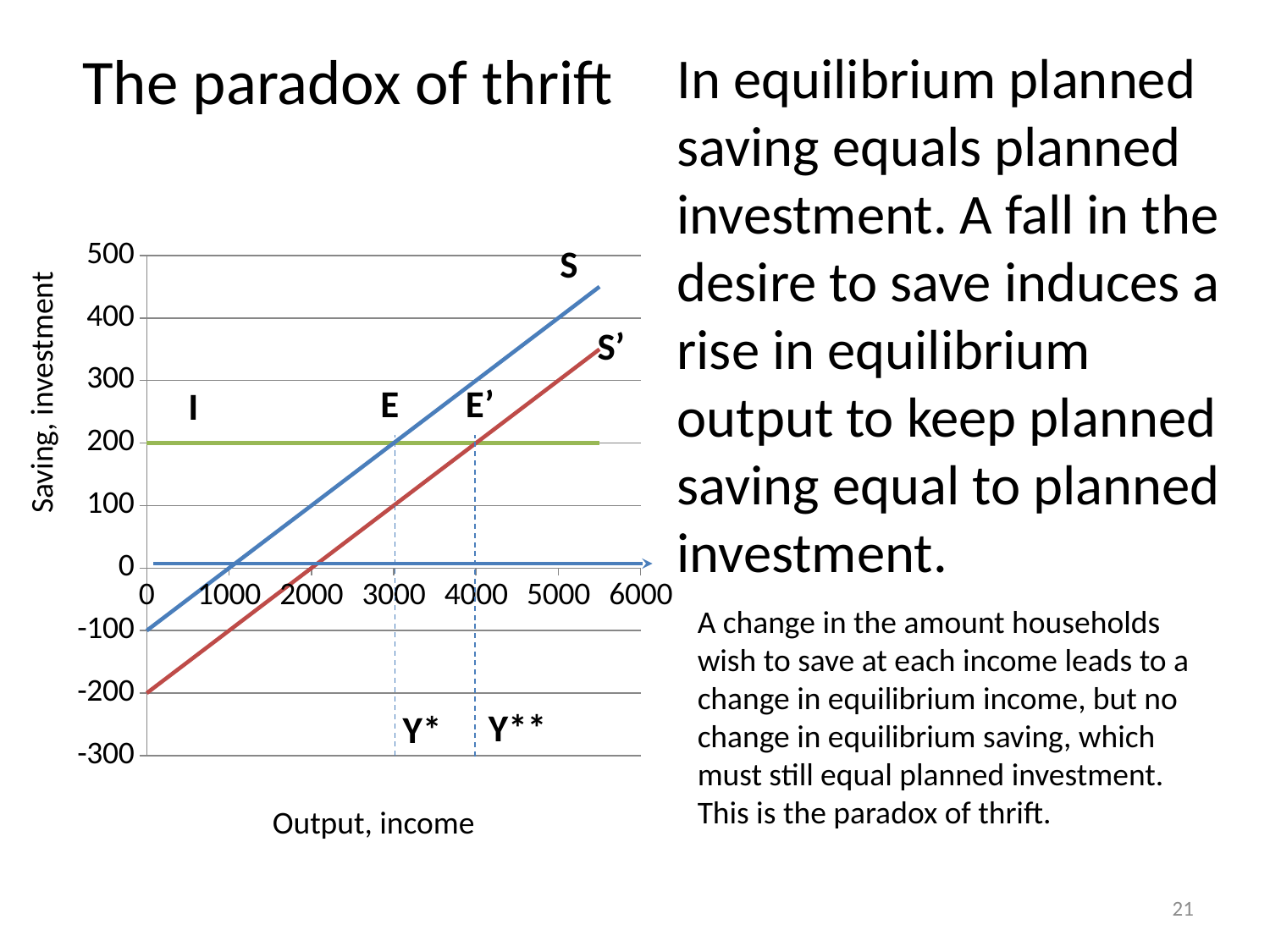
How many lines (S, S' and I) are plotted on the chart? 3 Does the S line rise or fall as output increases along the x axis? rise What is the value of the S line when output is 0? -100 What kind of chart is shown on the slide? line chart At an output of 2000, which line has the higher value, S or S'? S What is the label of the vertical axis of the chart? Saving, investment What is the value of the S' line when output is 0? -200 At what output level does the S' line cross the I line (point E')? 4000 Is the value of the S line at an output of 5000 greater or less than 300? greater What is the title of the chart on the slide? The paradox of thrift What is the value of the I line (planned investment) on the vertical axis? 200 At what output level does the S line cross the I line (point E)? 3000